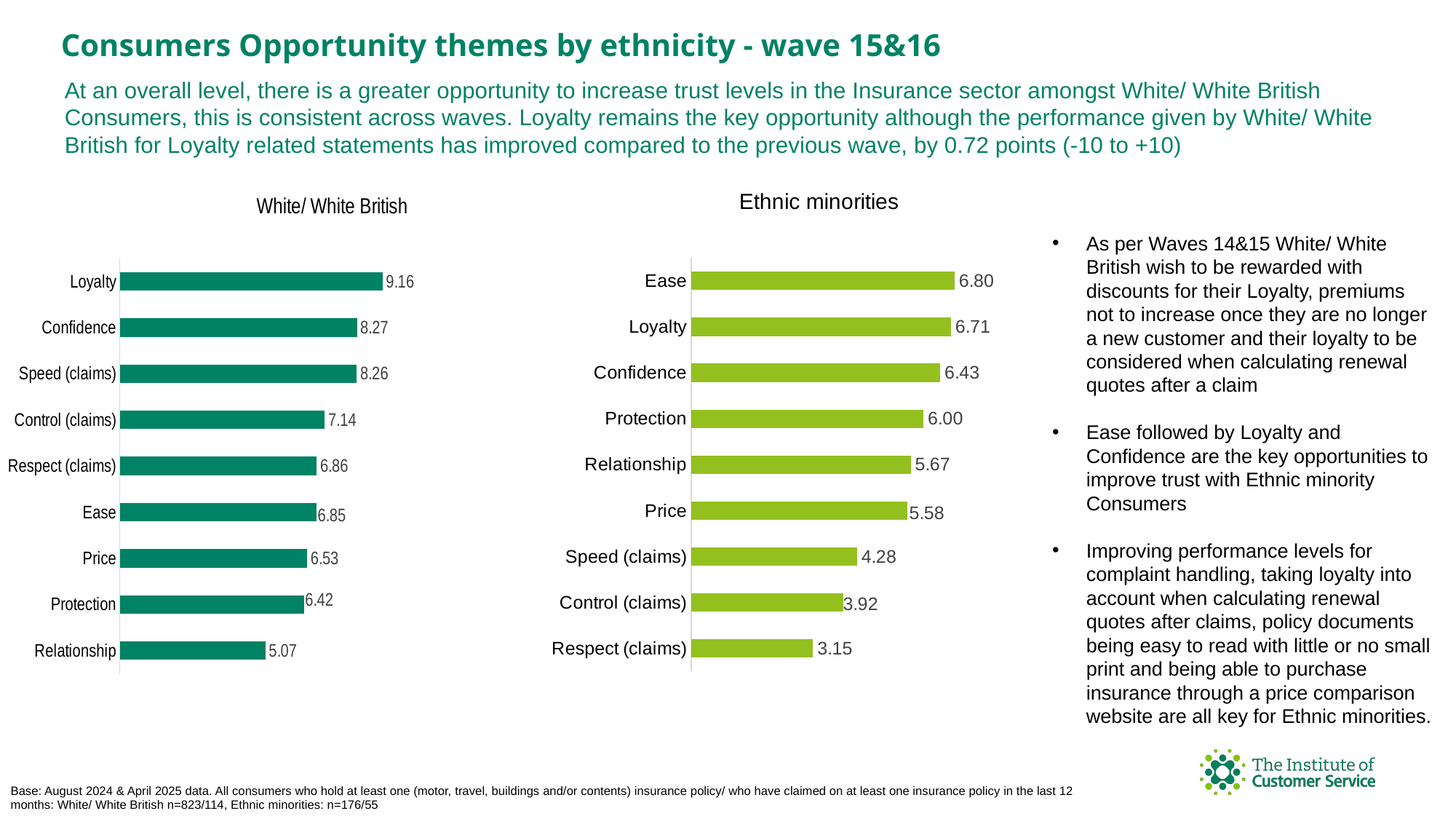
In the Ethnic minorities chart, what is the difference between Ease and Loyalty? 0.09 In the Ethnic minorities chart, which category has the lowest value? Respect (claims) What is the title of the chart on the left? White/ White British In the White/ White British chart, which category has the lowest value? Relationship In the White/ White British chart, which is larger: Control (claims) or Price? Control (claims) In the Ethnic minorities chart, what is the value for Ease? 6.80 What type of chart is the White/ White British chart? Bar chart In the Ethnic minorities chart, which category has the highest value? Ease In the White/ White British chart, what is the difference between Loyalty and Relationship? 4.09 In the Ethnic minorities chart, what is the value for Control (claims)? 3.92 How many categories are shown in the Ethnic minorities chart? 9 In the White/ White British chart, what is the value for Loyalty? 9.16